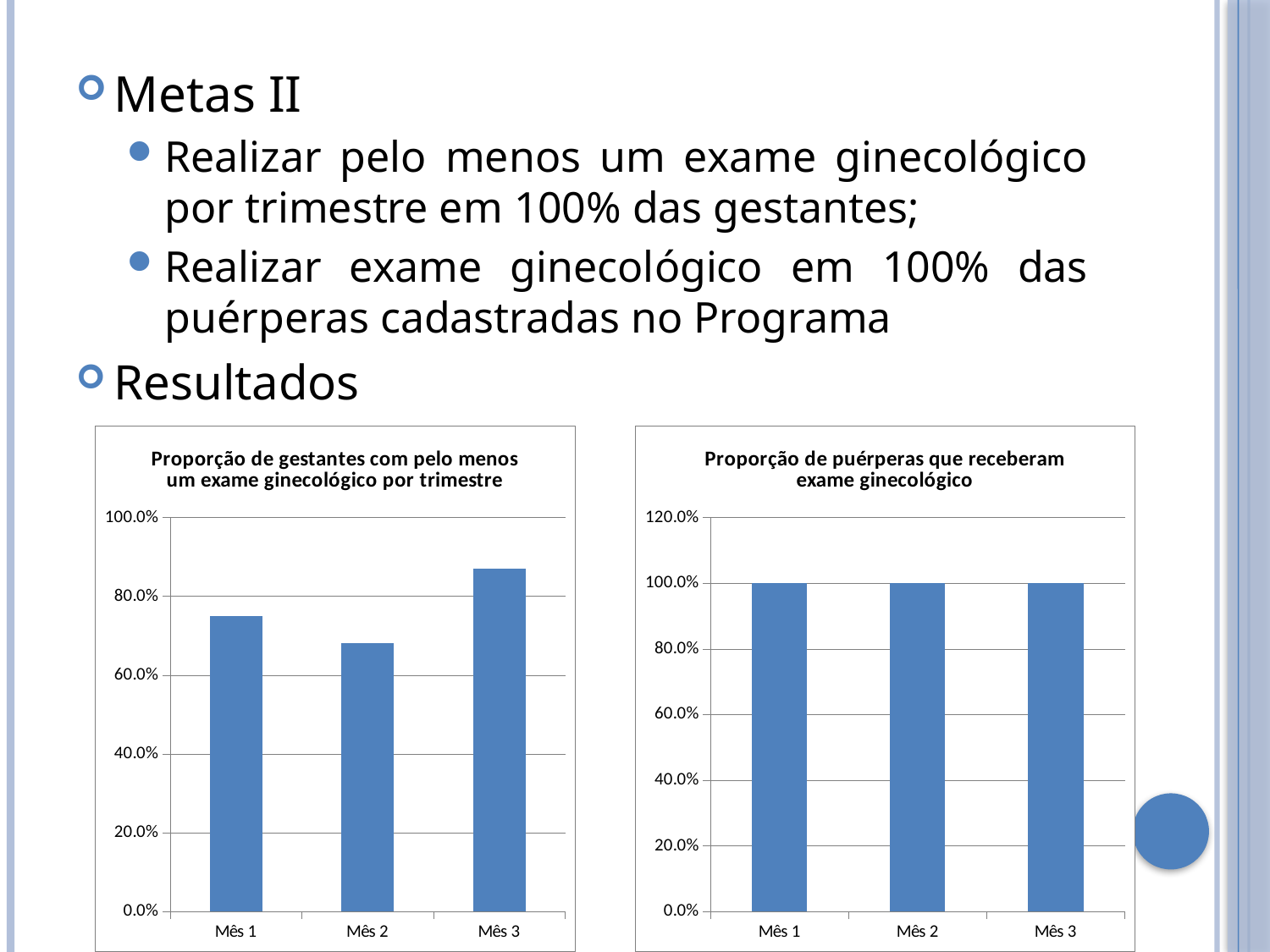
In the right chart, what is the highest value shown on the y axis? 120.0% What kind of chart is the chart titled 'Proporção de puérperas que receberam exame ginecológico'? bar chart In the left chart, which is larger, the value for Mês 1 or the value for Mês 2? Mês 1 In the chart titled 'Proporção de gestantes com pelo menos um exame ginecológico por trimestre', which month has the lowest value? Mês 2 In the left chart, is the value for Mês 3 greater or less than 80.0%? greater In the chart titled 'Proporção de puérperas que receberam exame ginecológico', what is the value for Mês 2? 100.0% How many months are shown on the x axis of the left chart? 3 What is the title of the chart on the left of the slide? Proporção de gestantes com pelo menos um exame ginecológico por trimestre In the left chart, is the value for Mês 1 greater or less than 80.0%? less In the left chart, is the value for Mês 2 greater or less than 60.0%? greater In the chart titled 'Proporção de gestantes com pelo menos um exame ginecológico por trimestre', which month has the highest value? Mês 3 In the chart titled 'Proporção de puérperas que receberam exame ginecológico', what is the value for Mês 3? 100.0%